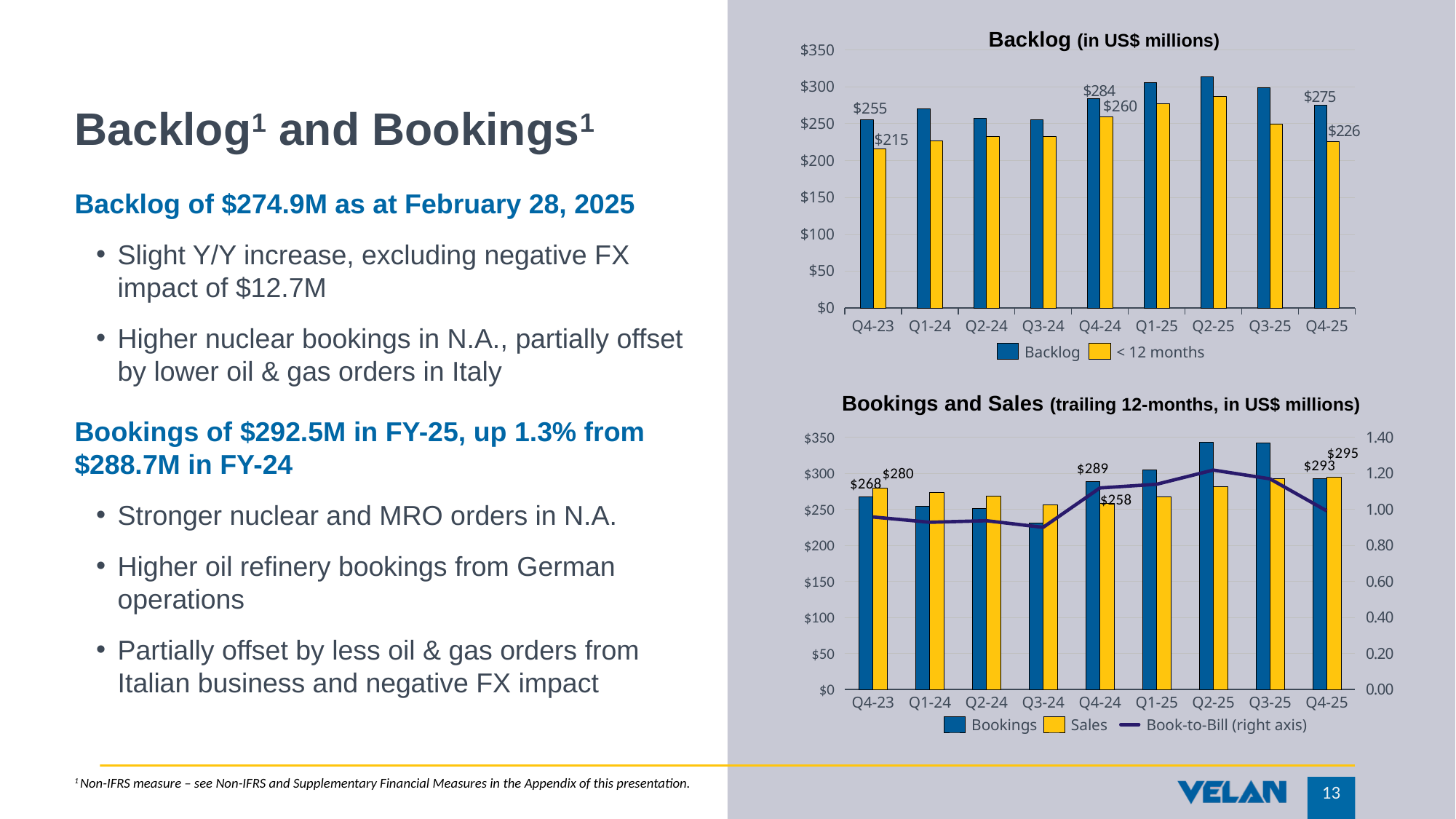
In the Bookings and Sales chart, which quarter has the lowest Bookings bar? Q3-24 In the Bookings and Sales chart, does the Book-to-Bill line rise or fall from Q3-24 to Q2-25? rise In the Backlog chart, what is the difference between the Backlog and < 12 months values for Q4-25? $49 In the Backlog chart, which quarter has the highest Backlog bar? Q2-25 In the Bookings and Sales chart, what is the Sales value for Q4-24? $258 In the Backlog chart, is the Backlog value for Q1-25 greater or less than $300? greater How many quarters are shown on the x axis of the Backlog chart? 9 In the Backlog chart, what is the Backlog value for Q4-25? $275 In the Bookings and Sales chart, what is the difference between Bookings and Sales for Q4-24? $31 How many series does the legend of the Bookings and Sales chart list? 3 In the Bookings and Sales chart, which is larger for Q4-23, Bookings or Sales? Sales In the Backlog chart, what is the < 12 months value for Q4-23? $215